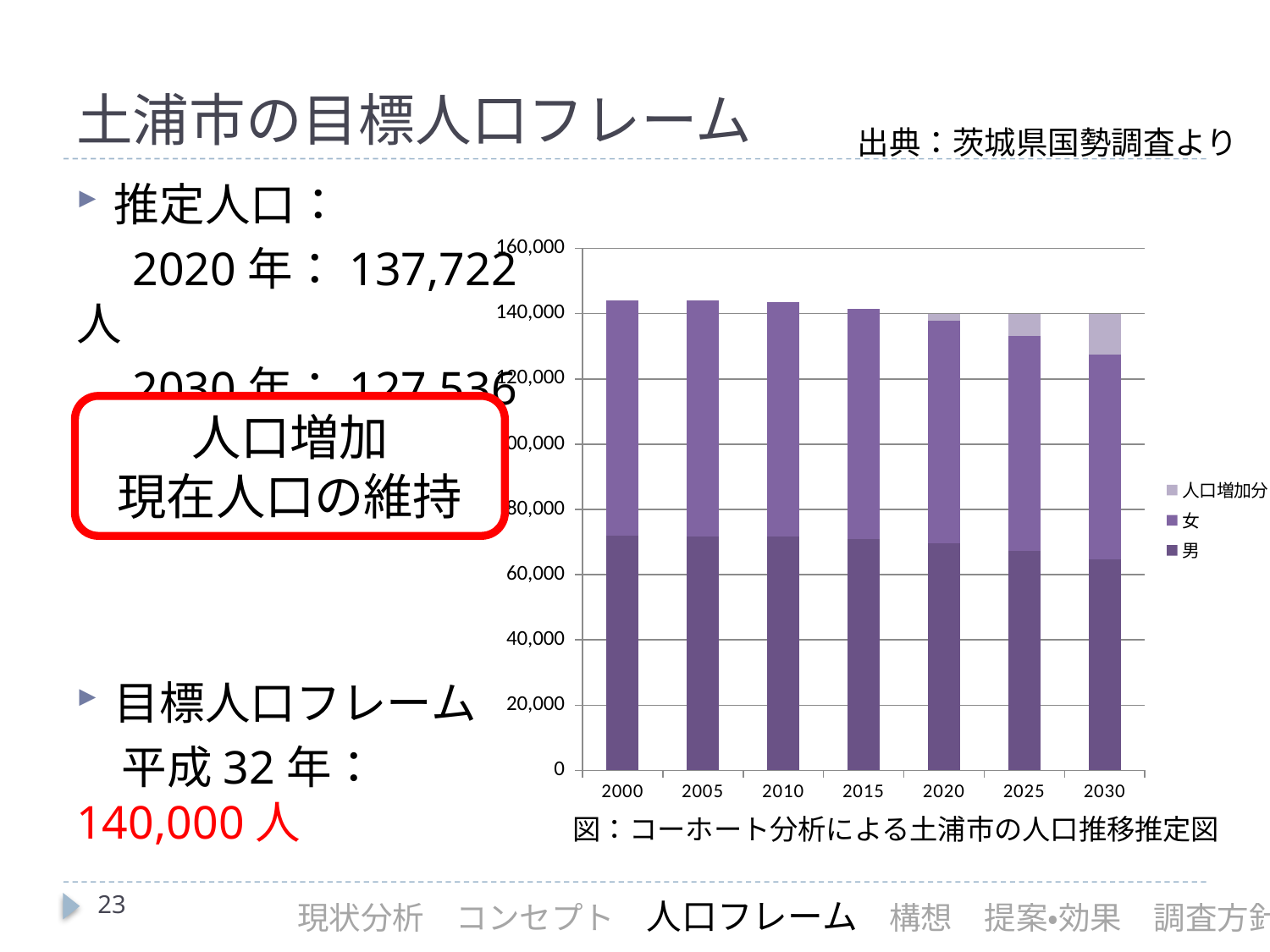
Does the 男 series rise or fall from 2000 to 2030? fall What is the highest tick value shown on the chart's y axis? 160,000 Is the total stacked bar for 2000 greater or less than 120,000? greater What kind of chart is shown on the slide? stacked bar chart Which is larger, the 男 value in 2000 or the 男 value in 2030? 2000 What is the first year shown on the x axis of the chart? 2000 Which year has the lowest value for 男? 2030 How many years are shown along the x axis of the chart? 7 What are the three series listed in the chart's legend? 人口増加分, 女, 男 Is the value for 男 in 2000 greater or less than 60,000? greater What is the last year shown on the x axis of the chart? 2030 How many series does the chart's legend list? 3